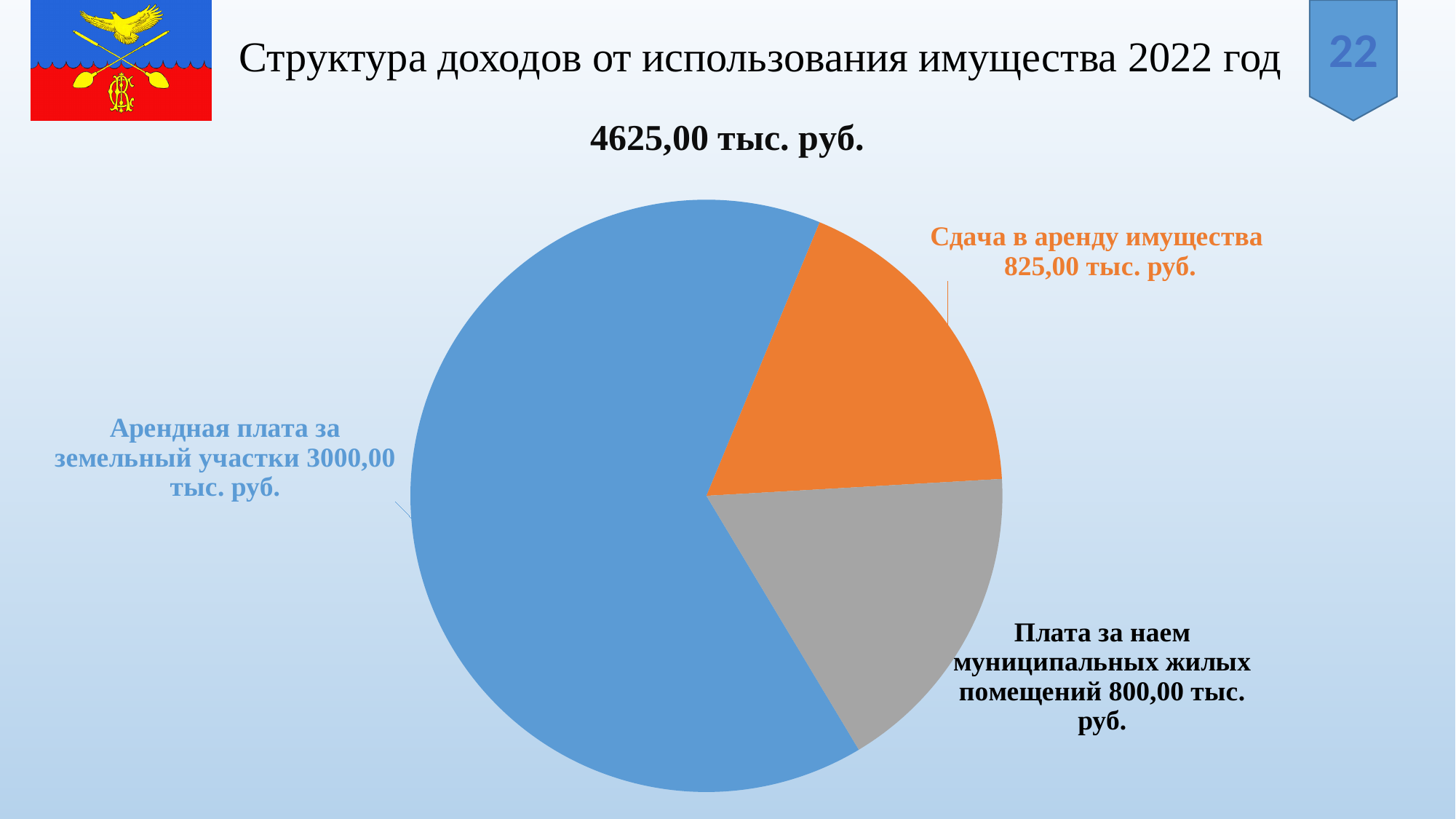
How many slices does the pie chart have? 3 What is the value for Арендная плата за земельный участки? 3000,00 тыс. руб. What kind of chart is shown on the slide? pie chart Which category has the smallest value? Плата за наем муниципальных жилых помещений Which is larger: Сдача в аренду имущества or Плата за наем муниципальных жилых помещений? Сдача в аренду имущества Which category has the largest slice of the pie? Арендная плата за земельный участки What is the value for Плата за наем муниципальных жилых помещений? 800,00 тыс. руб. What total amount is shown above the pie chart? 4625,00 тыс. руб. What is the difference between Сдача в аренду имущества and Плата за наем муниципальных жилых помещений? 25,00 тыс. руб. What is the value for Сдача в аренду имущества? 825,00 тыс. руб. What is the difference between Арендная плата за земельный участки and Сдача в аренду имущества? 2175,00 тыс. руб. What colour is the slice for Плата за наем муниципальных жилых помещений? grey